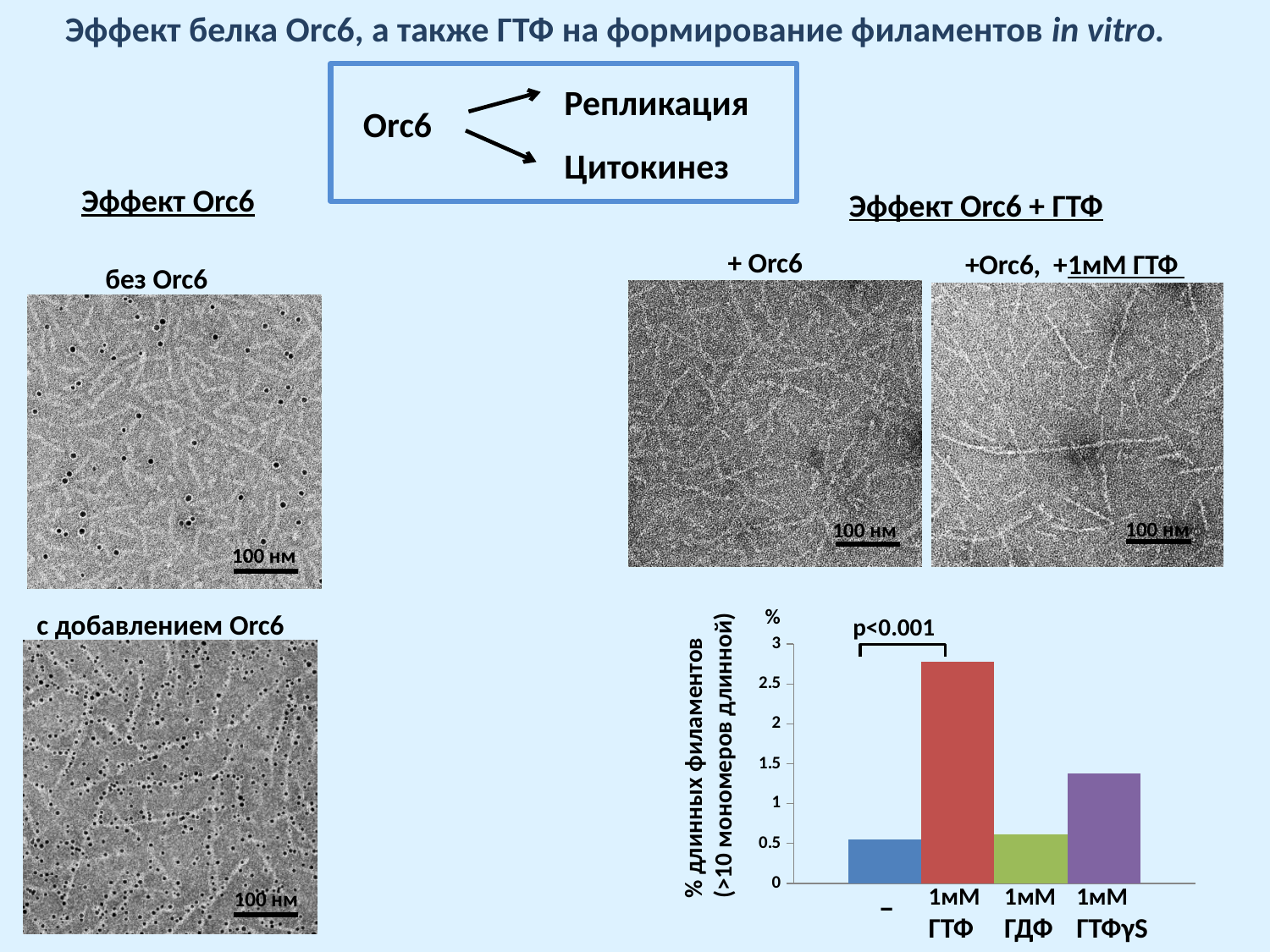
Is the value for 1мМ ГТФγS greater or less than 1? greater What p-value is annotated above the bars in the chart? p<0.001 Which category has the highest bar in the chart? 1мМ ГТФ Is the value for 1мМ ГТФγS greater or less than 2? less Is the value for 1мМ ГДФ greater or less than 1? less How many bars (categories) does the bar chart show? 4 Which is larger, the value for 1мМ ГТФγS or the value for 1мМ ГДФ? 1мМ ГТФγS Which is larger, the value for 1мМ ГТФ or the value for 1мМ ГТФγS? 1мМ ГТФ What colour is the bar for 1мМ ГТФ? red What kind of chart is shown at the bottom right of the slide? bar chart